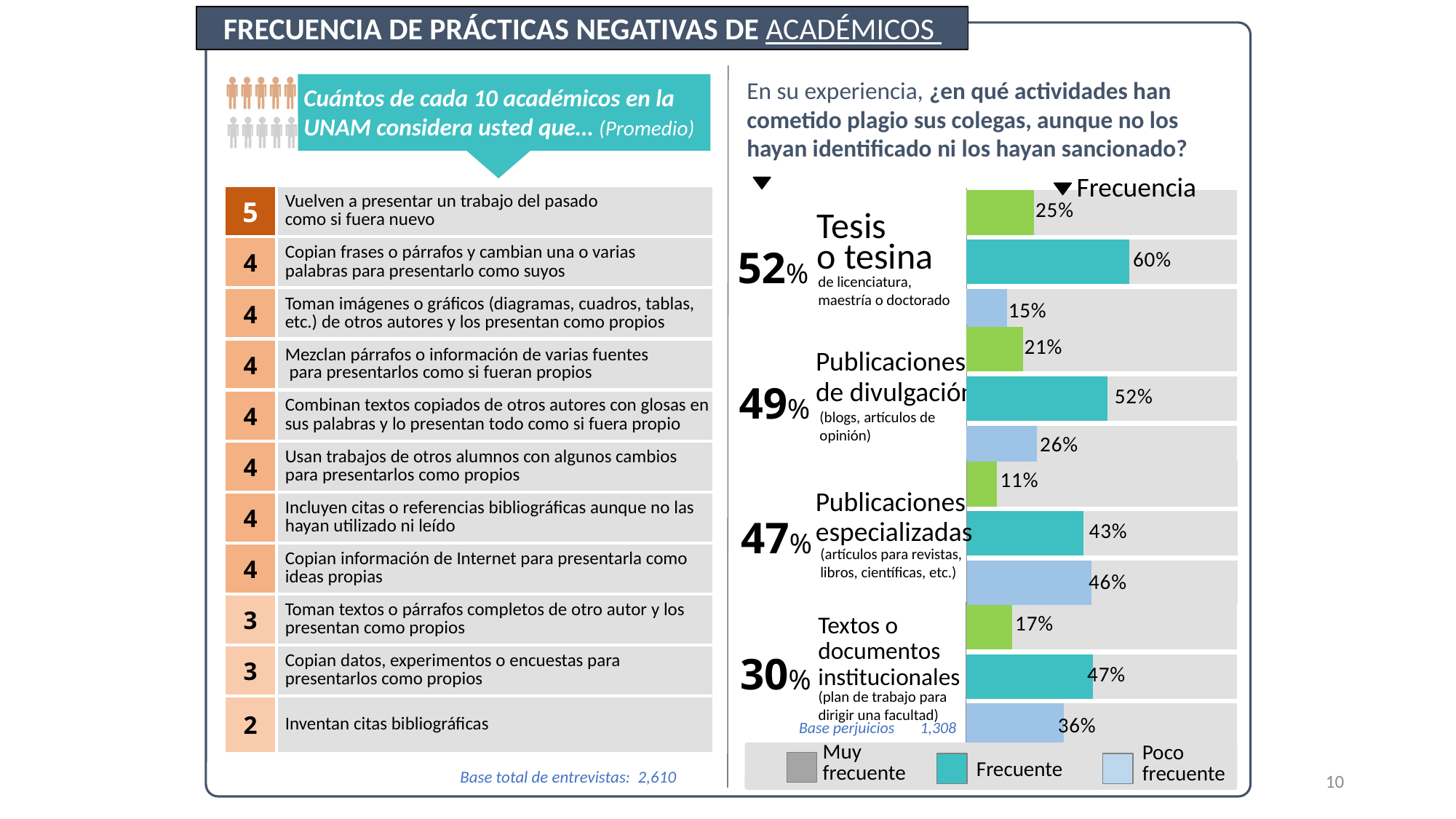
What is the 'Poco frecuente' value for 'Publicaciones especializadas'? 46% What percentage of respondents said plagiarism in 'Tesis o tesina' is 'Frecuente'? 60% What is the total of the three frequency values for 'Tesis o tesina'? 100% What kind of chart is used to show the frequency of plagiarism by activity? Bar chart How many series does the chart legend list? 3 Which category has the highest 'Frecuente' value? Tesis o tesina What is the 'Frecuente' value for 'Publicaciones de divulgación'? 52% How many categories (activity types) are shown in the bar chart? 4 What is the 'Muy frecuente' value for 'Textos o documentos institucionales'? 17% For 'Publicaciones especializadas', which is larger: the 'Frecuente' value or the 'Poco frecuente' value? Poco frecuente Which category has the lowest 'Muy frecuente' value? Publicaciones especializadas What is the difference between the 'Frecuente' values for 'Tesis o tesina' and 'Publicaciones especializadas'? 17%